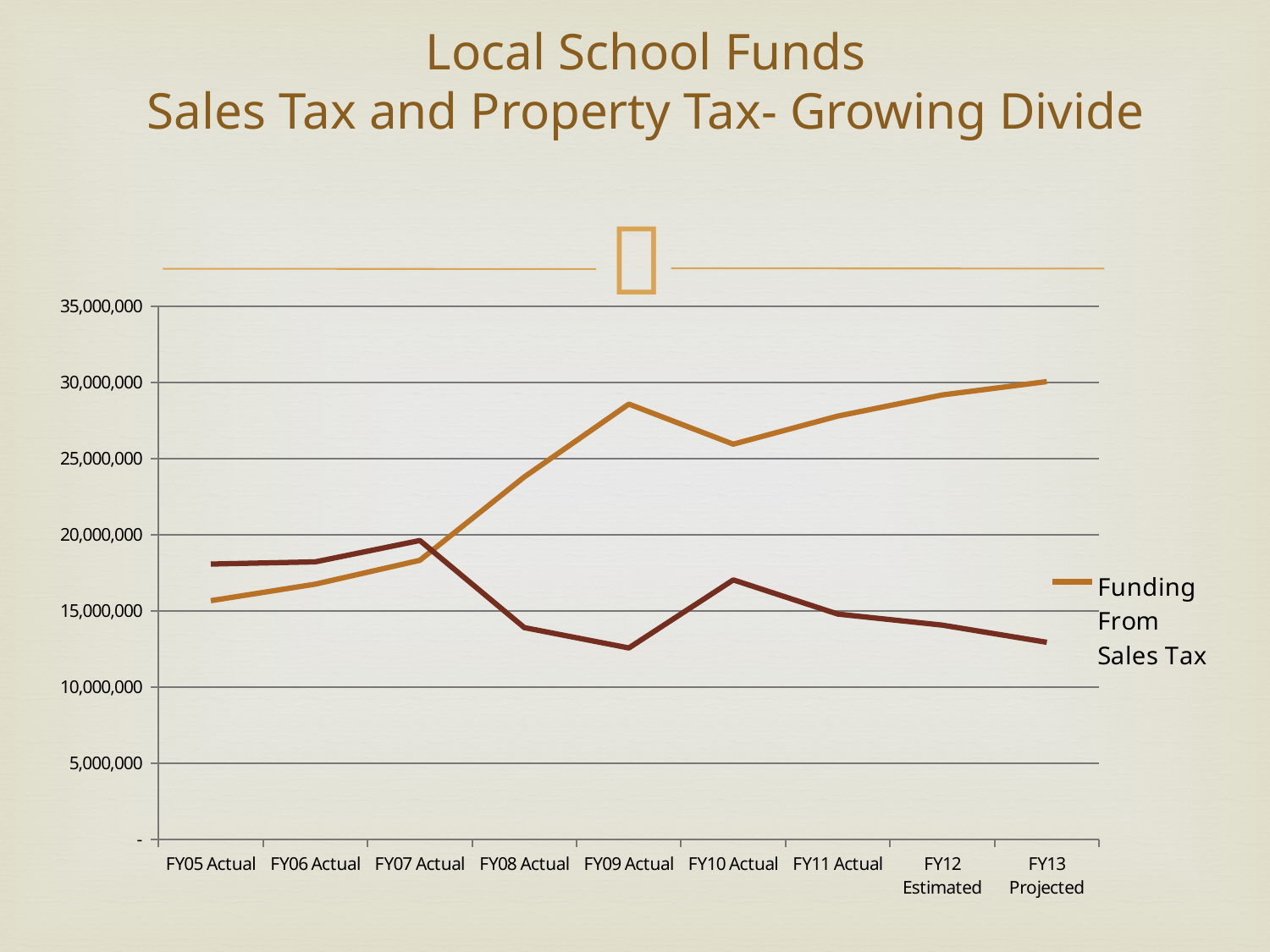
What series name appears in the legend? Funding From Sales Tax In which fiscal year is Funding From Sales Tax highest? FY13 Projected How many fiscal-year categories are shown along the x axis? 9 How many series does the legend list? 1 What kind of chart is shown on the slide? line chart What is the title of the chart on the slide? Local School Funds Sales Tax and Property Tax- Growing Divide Is the Funding From Sales Tax value for FY09 Actual greater or less than 30,000,000? less Is the Funding From Sales Tax value for FY05 Actual greater or less than 15,000,000? greater Which is larger for Funding From Sales Tax: FY09 Actual or FY10 Actual? FY09 Actual Is the Funding From Sales Tax value for FY08 Actual greater or less than 20,000,000? greater In which fiscal year is Funding From Sales Tax lowest? FY05 Actual